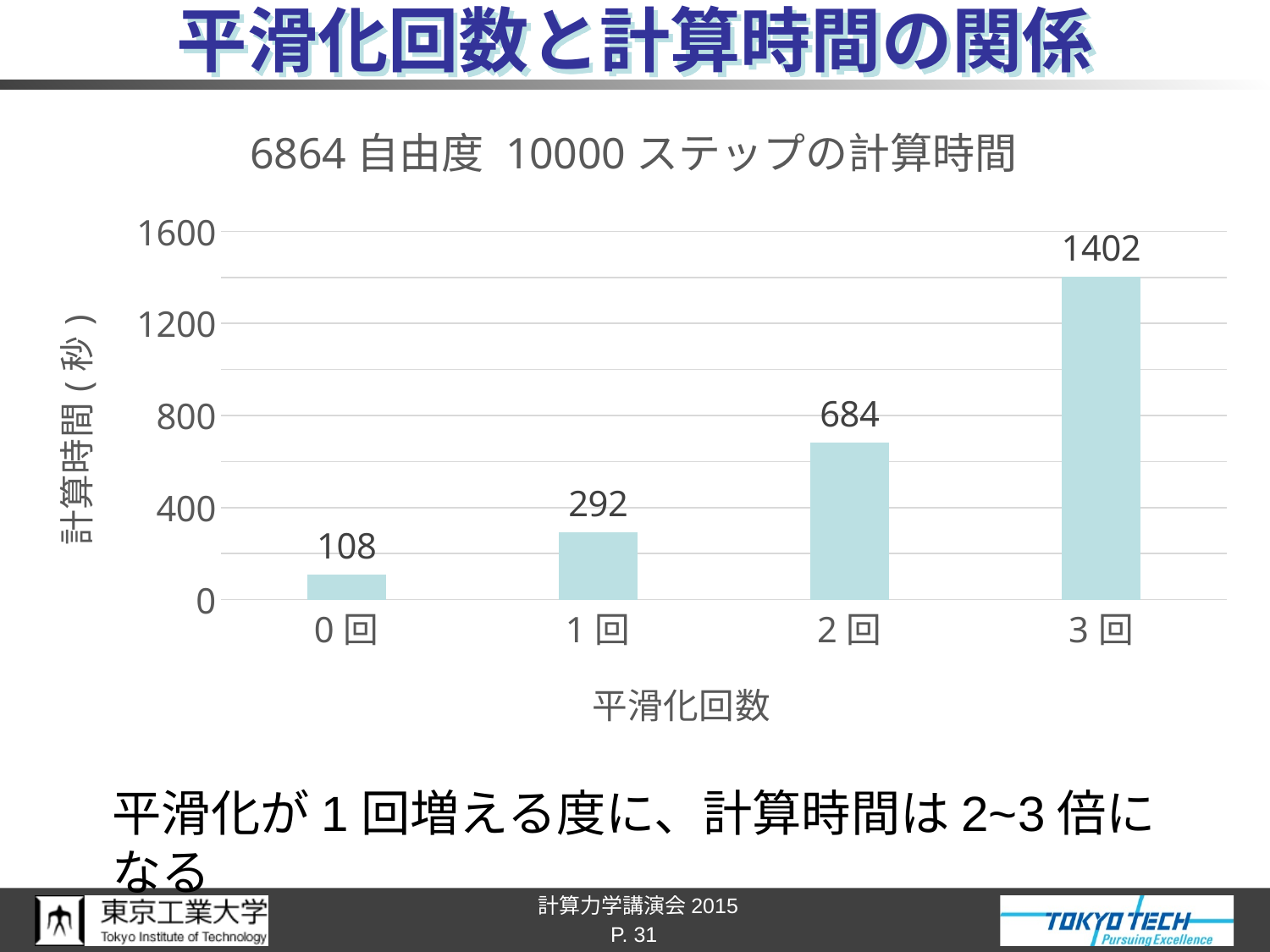
What kind of chart is shown on the slide? Bar chart Which has a larger computation time, 1 回 or 2 回? 2 回 What is the difference in computation time between 1 回 and 0 回? 184 How many categories (smoothing counts) are shown on the x axis? 4 What is the computation time for 2 回? 684 Which smoothing count has the highest computation time? 3 回 What is the computation time for 1 回? 292 What is the difference in computation time between 3 回 and 2 回? 718 What is the computation time for 0 回 (0 smoothing iterations)? 108 Do the computation times rise or fall as the smoothing count increases along the x axis? Rise What is the computation time for 3 回? 1402 Which smoothing count has the lowest computation time? 0 回